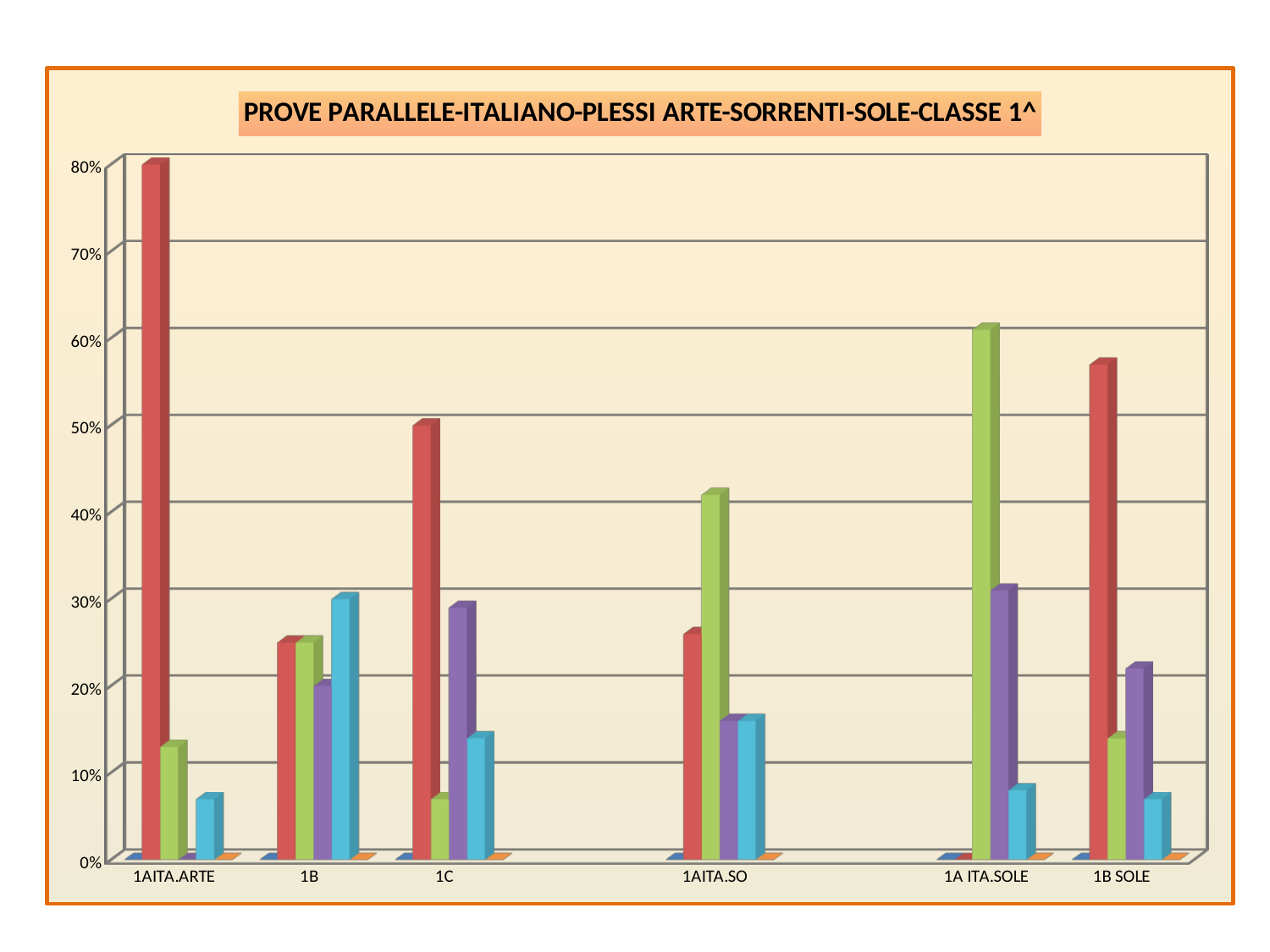
Is the red bar for 1B SOLE greater or less than 50%? greater Is the green bar for 1AITA.SO greater or less than 30%? greater How many categories are shown on the x axis of the chart? 6 Is the light blue bar for 1AITA.ARTE greater or less than 10%? less Which is larger, the green bar for 1A ITA.SOLE or the green bar for 1AITA.SO? 1A ITA.SOLE Which category contains the tallest bar in the chart? 1AITA.ARTE What is the highest value shown on the vertical axis of the chart? 80% What is the title of the chart? PROVE PARALLELE-ITALIANO-PLESSI ARTE-SORRENTI-SOLE-CLASSE 1^ Which is larger, the red bar for 1AITA.ARTE or the red bar for 1C? 1AITA.ARTE What kind of chart is shown on the slide? bar chart